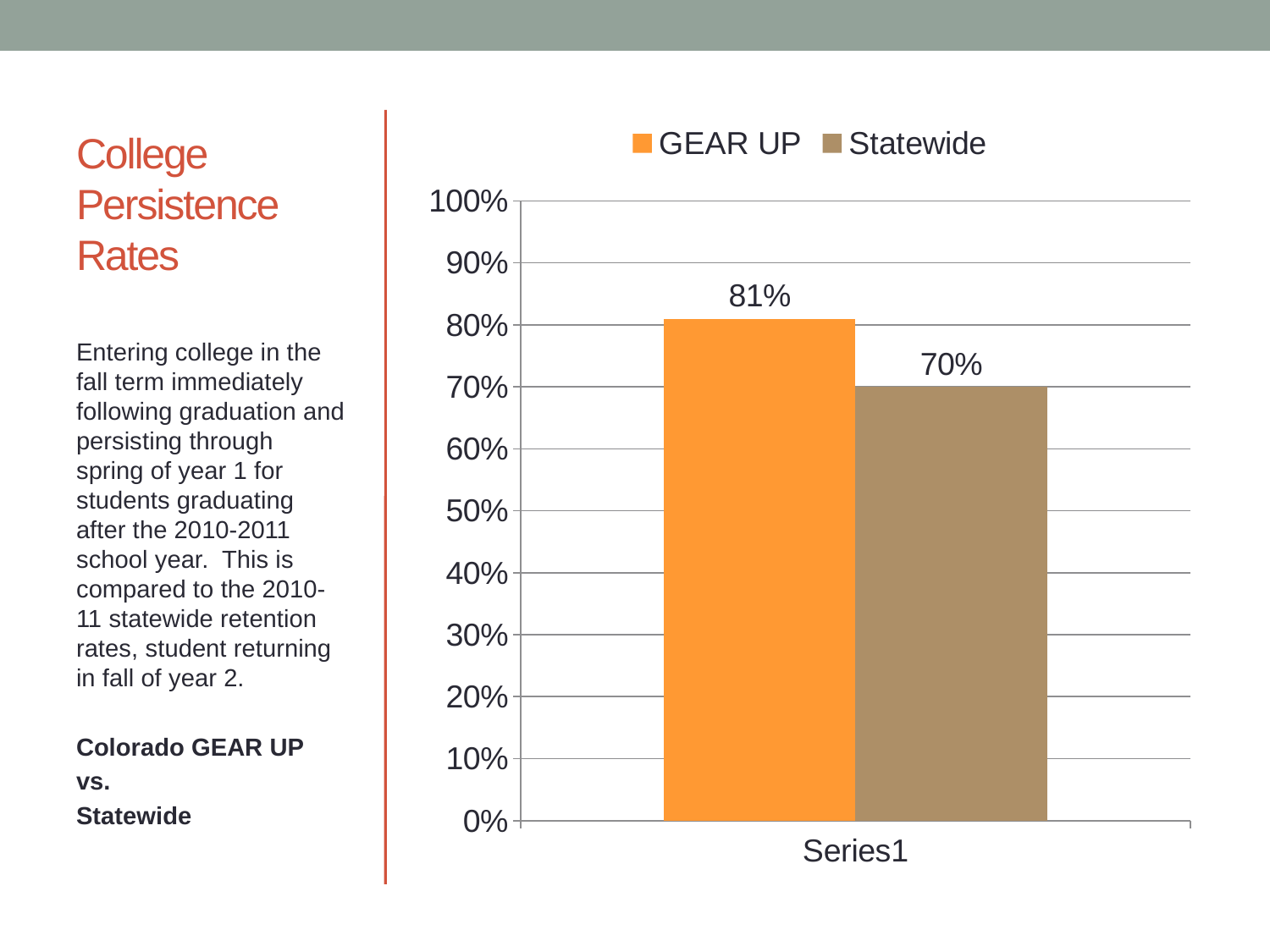
Is the value for GEAR UP greater or less than 80%? greater What label appears on the x axis under the bars? Series1 Is the GEAR UP value larger or smaller than the Statewide value? larger What colour is the GEAR UP bar? orange What kind of chart is shown on the slide? bar chart Which series has the lower value, GEAR UP or Statewide? Statewide Is the value for Statewide greater or less than 80%? less How many series does the legend list? 2 What is the college persistence rate for Statewide? 70% What is the difference between the GEAR UP and Statewide values? 11% Which series has the higher value, GEAR UP or Statewide? GEAR UP What is the college persistence rate for GEAR UP? 81%